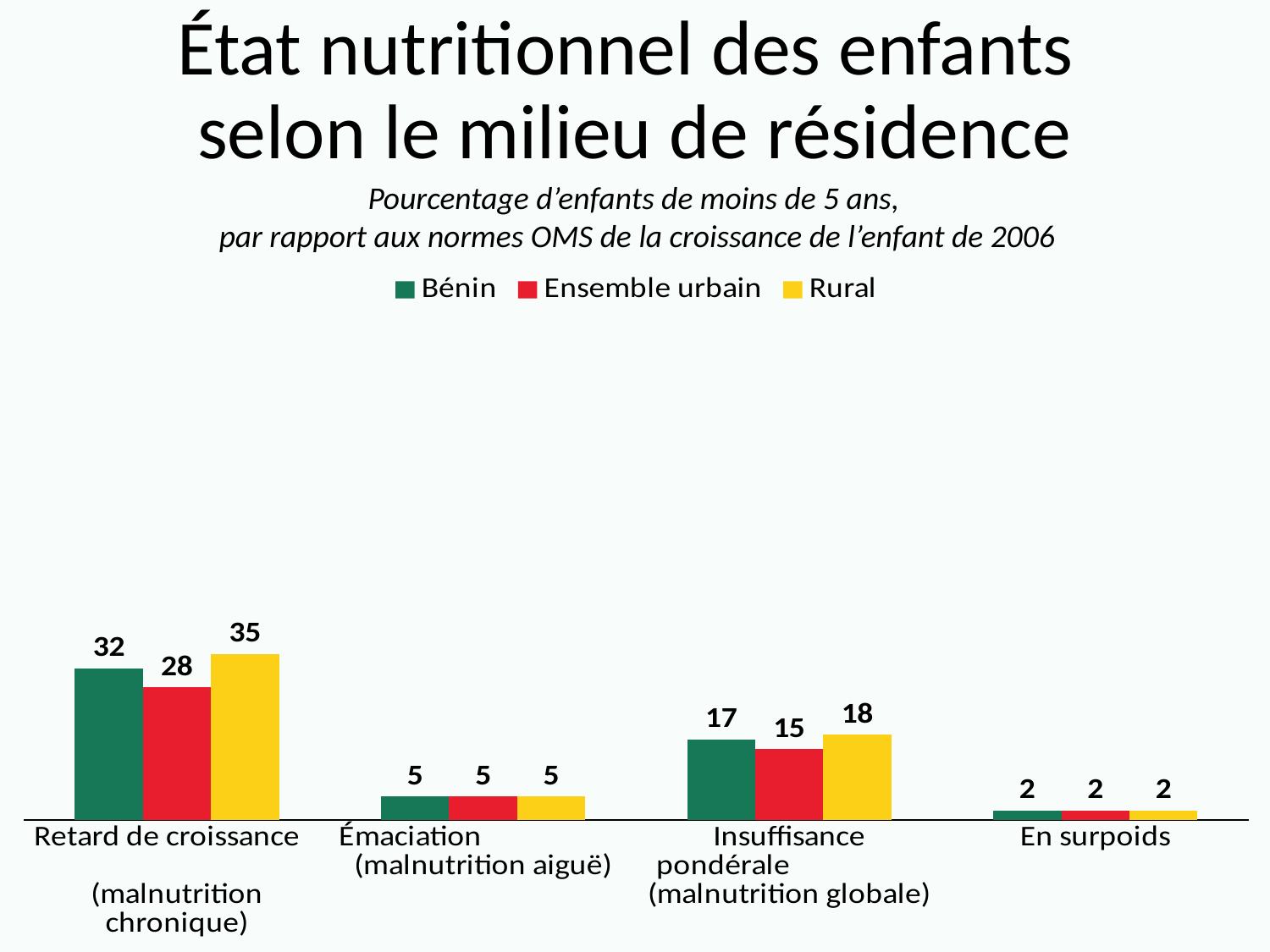
Which series is shown in yellow in the legend? Rural What is the difference between the Rural and Ensemble urbain values for Retard de croissance? 7 What is the value for Bénin in the Émaciation category? 5 What is the value for Rural in the Retard de croissance category? 35 What is the difference between the Bénin and Ensemble urbain values for Insuffisance pondérale? 2 Which is larger for Insuffisance pondérale: the Bénin value or the Rural value? Rural How many categories are shown on the x axis? 4 Which category has the highest value for Bénin? Retard de croissance What is the value for Ensemble urbain in the Insuffisance pondérale category? 15 What kind of chart is shown on the slide? bar chart Which category has the lowest value for Rural? En surpoids How many series does the legend list? 3